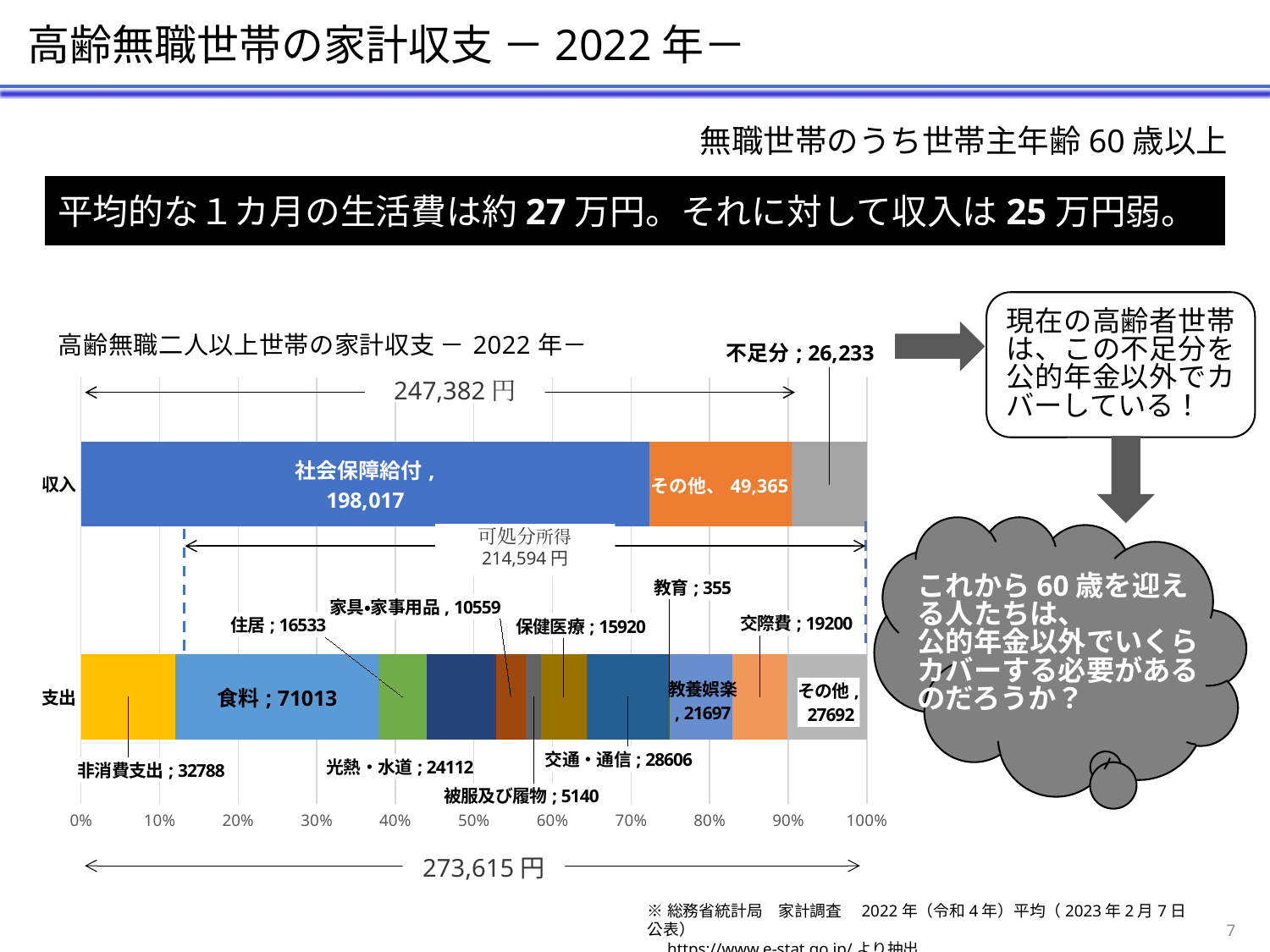
What type of chart is shown on the slide? Stacked bar chart What is the value of 食料 in the 支出 bar? 71013 What is the total of the 支出 bar as printed below the chart? 273,615 円 What is the title of the chart? 高齢無職二人以上世帯の家計収支 － 2022 年－ Which expenditure category in the 支出 bar has the smallest value? 教育 Which is larger in the 支出 bar, 光熱・水道 or 交際費? 光熱・水道 What is the value of 社会保障給付 in the 収入 bar? 198,017 What is the difference between 社会保障給付 (198,017) and その他 (49,365) in the 収入 bar? 148,652 What is the total of 社会保障給付 and その他 in the 収入 bar, as printed above the chart? 247,382 円 What is the value labelled 不足分? 26,233 Which expenditure category in the 支出 bar has the largest value? 食料 What is the value of 交通・通信 in the 支出 bar? 28606